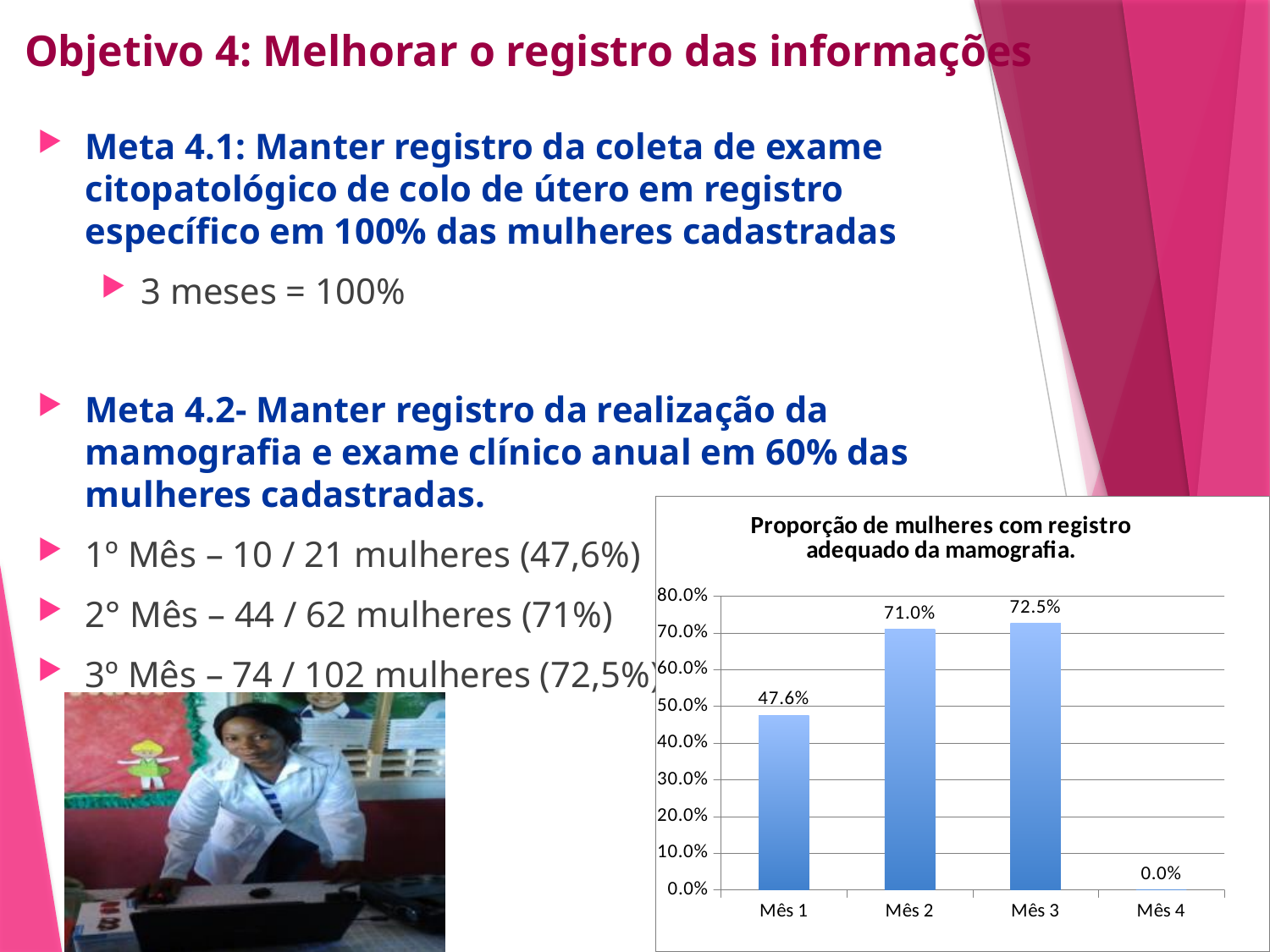
What is the value for Mês 1 in the chart? 47.6% How many categories are shown on the x axis of the chart? 4 Which category has the lowest value in the chart? Mês 4 What is the difference between the values for Mês 2 and Mês 1? 23.4% Which category has the highest value in the chart? Mês 3 Is the value for Mês 1 greater or less than 50.0%? less What is the value for Mês 3 in the chart? 72.5% What kind of chart is shown on the slide? bar chart What is the title of the chart? Proporção de mulheres com registro adequado da mamografia. What is the value for Mês 2 in the chart? 71.0% Which is larger, the value for Mês 1 or the value for Mês 2? Mês 2 What is the value for Mês 4 in the chart? 0.0%